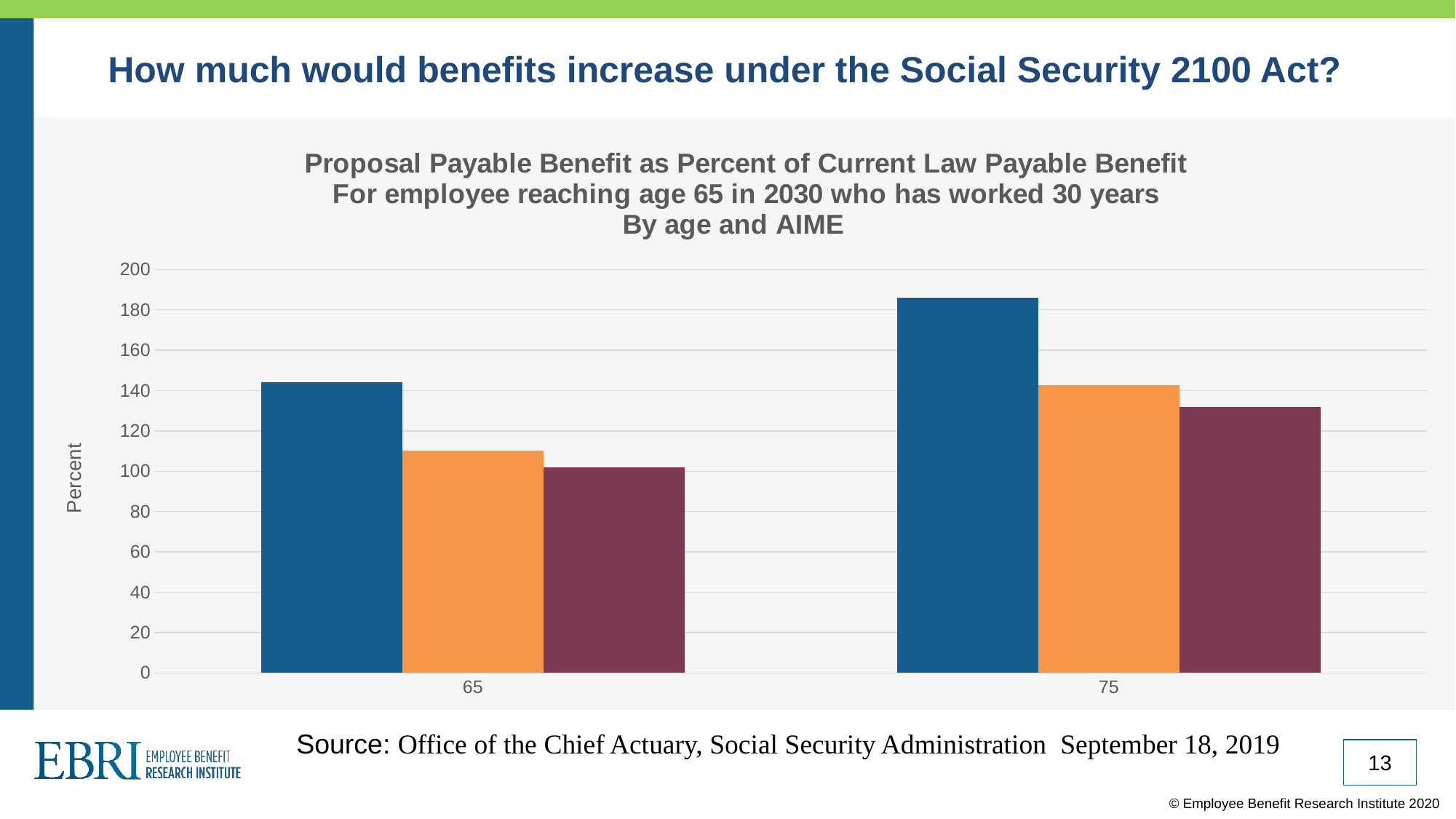
Is the value of the purple bar for age 75 greater or less than 140? less For age 65, which is larger: the blue bar or the orange bar? the blue bar How many age categories are shown on the x axis? 2 Do the blue bars rise or fall from age 65 to age 75? rise Which age category has the tallest bar? 75 Is the value of the orange bar for age 65 greater or less than 120? less Is the value of the purple bar for age 65 greater or less than 120? less What is the label on the y axis of the chart? Percent What kind of chart is shown on the slide? bar chart